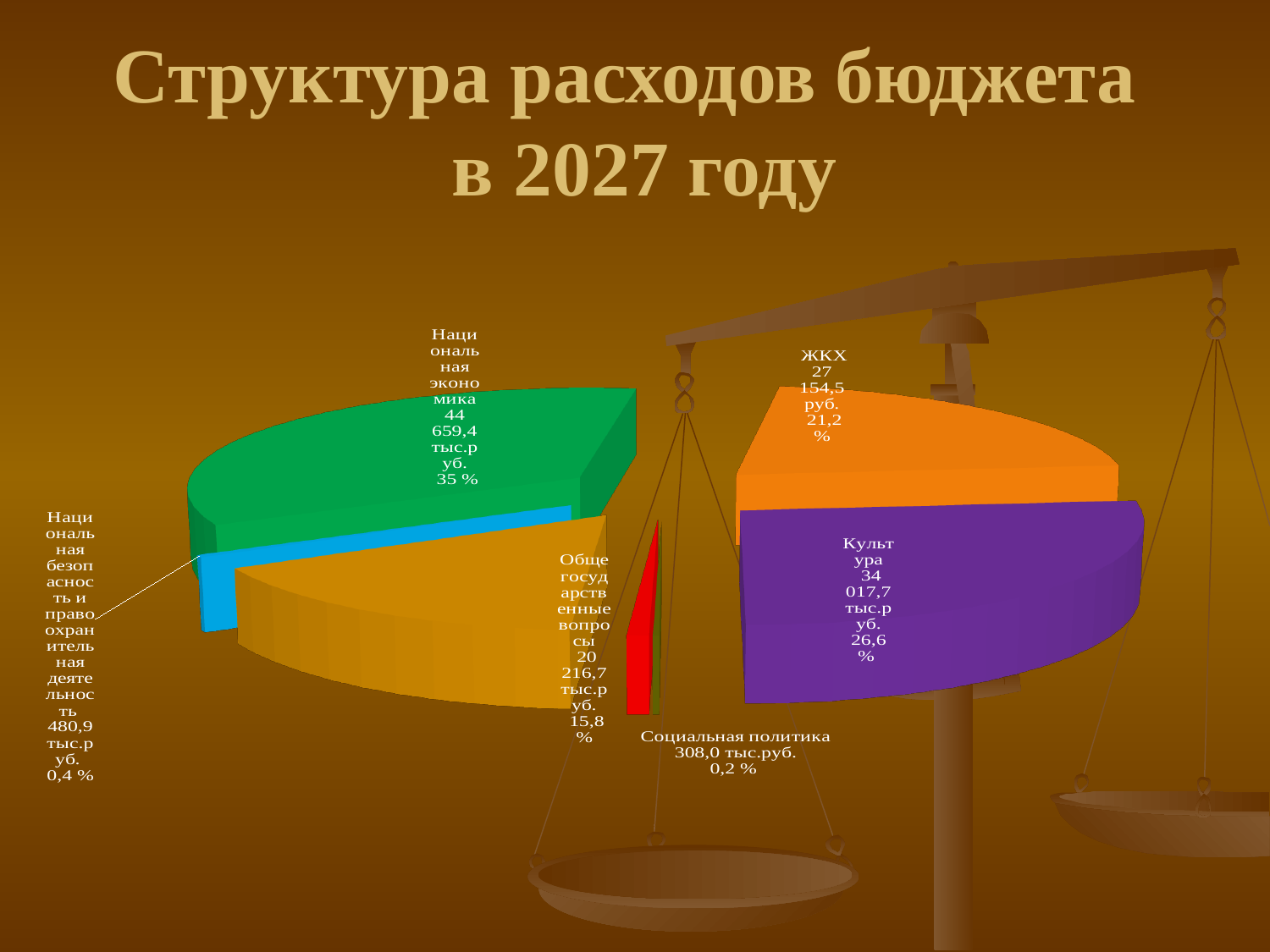
Which has a larger share, Культура or ЖКХ? Культура What is the value shown for Культура? 34 017,7 тыс.руб. How many slices does the pie chart have? 7 What percentage is shown for ЖКХ? 21,2 % Which category has the smallest share of the pie? Социальная политика What is the title of the chart on the slide? Структура расходов бюджета в 2027 году What share of the pie does Национальная экономика have? 35 % Which category has the largest share of the pie? Национальная экономика What is the value shown for Общегосударственные вопросы? 20 216,7 тыс.руб. What is the value shown for Национальная безопасность и правоохранительная деятельность? 480,9 тыс.руб. What kind of chart is shown on the slide? pie chart What percentage is shown for Социальная политика? 0,2 %